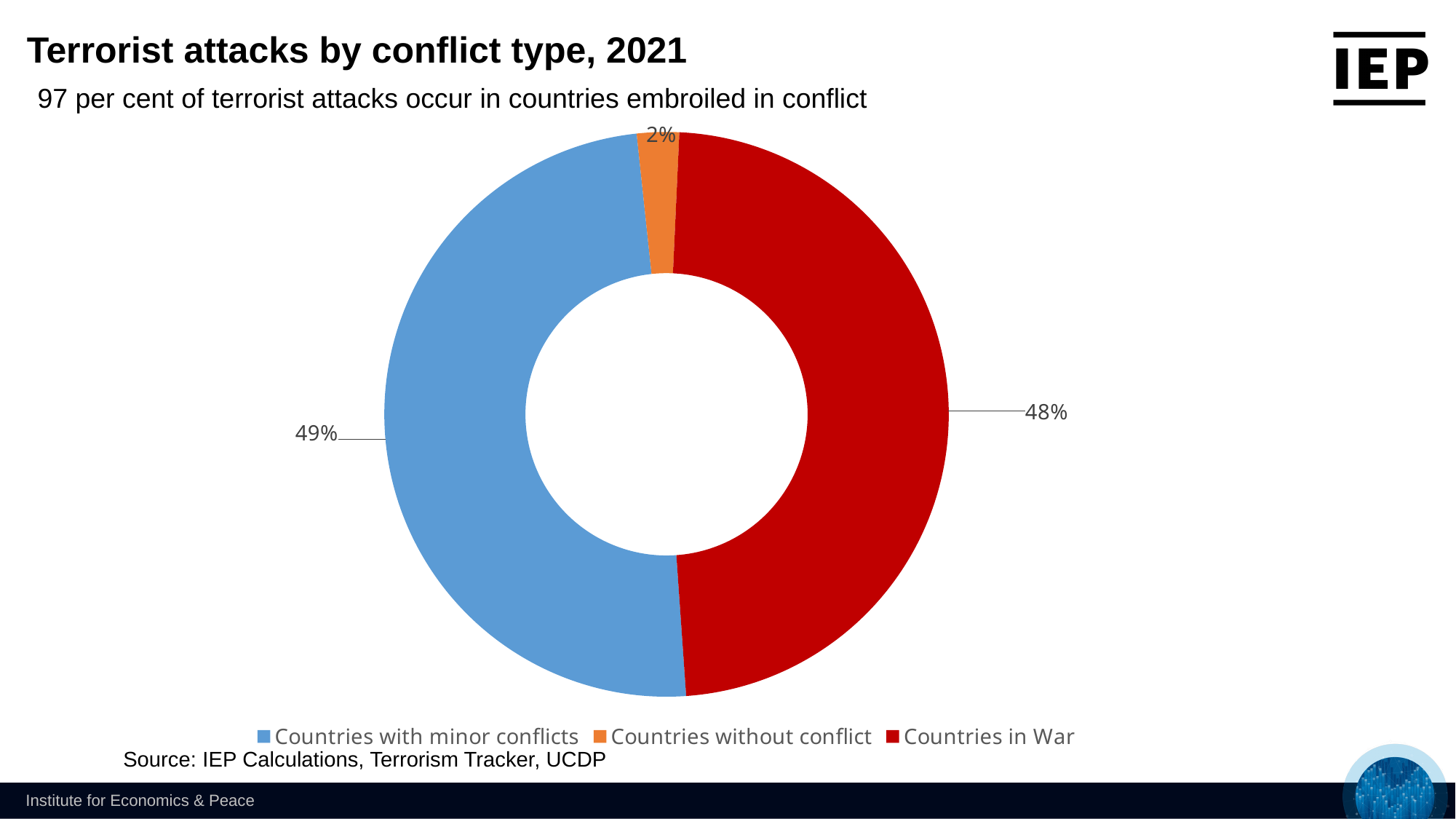
What is the title of the chart? Terrorist attacks by conflict type, 2021 What is the difference in percentage points between the share for countries in war and the share for countries without conflict? 46 percentage points Which colour represents countries in war in the chart? Red What kind of chart is shown on the slide? Pie (doughnut) chart What share of terrorist attacks occurred in countries in war? 48% What share of terrorist attacks occurred in countries with minor conflicts? 49% Which is larger: the share for countries in war or the share for countries without conflict? Countries in War Which category has the largest share of terrorist attacks? Countries with minor conflicts Which category has the smallest share of terrorist attacks? Countries without conflict What is the difference in percentage points between the share for countries with minor conflicts and the share for countries in war? 1 percentage point How many categories does the chart show? 3 What share of terrorist attacks occurred in countries without conflict? 2%